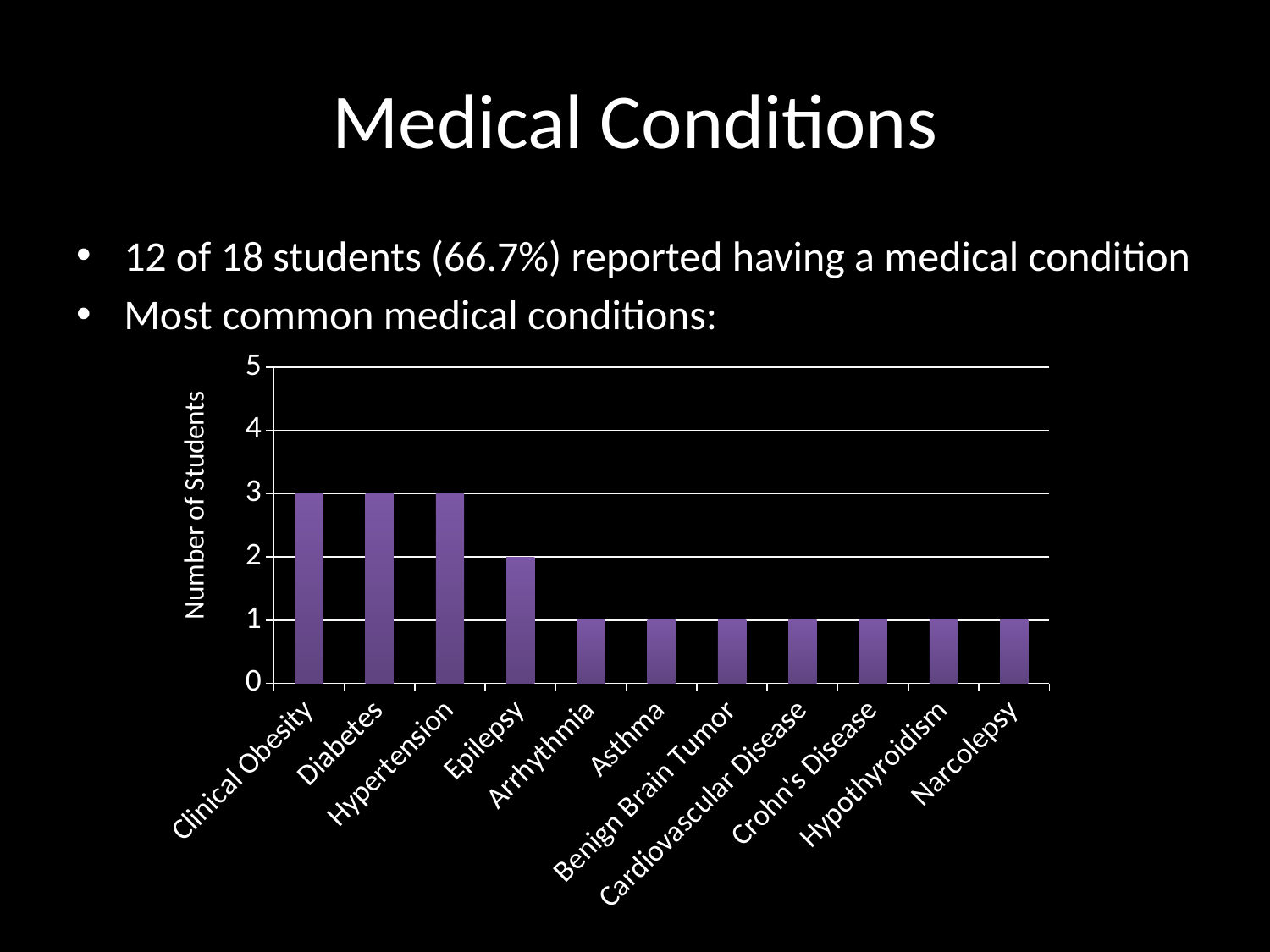
How many medical conditions (categories) are shown on the x axis of the chart? 11 Do the values generally rise or fall moving left to right along the x axis? fall What is the number of students for Narcolepsy? 1 Which has more students, Epilepsy or Arrhythmia? Epilepsy Which has more students, Diabetes or Asthma? Diabetes Is the value for Epilepsy greater or less than 3? less What is the number of students for Epilepsy? 2 What is the number of students for Clinical Obesity? 3 What is the label of the vertical axis of the chart? Number of Students What is the difference in number of students between Clinical Obesity and Epilepsy? 1 What is the number of students for Hypertension? 3 What kind of chart is shown on the slide? bar chart